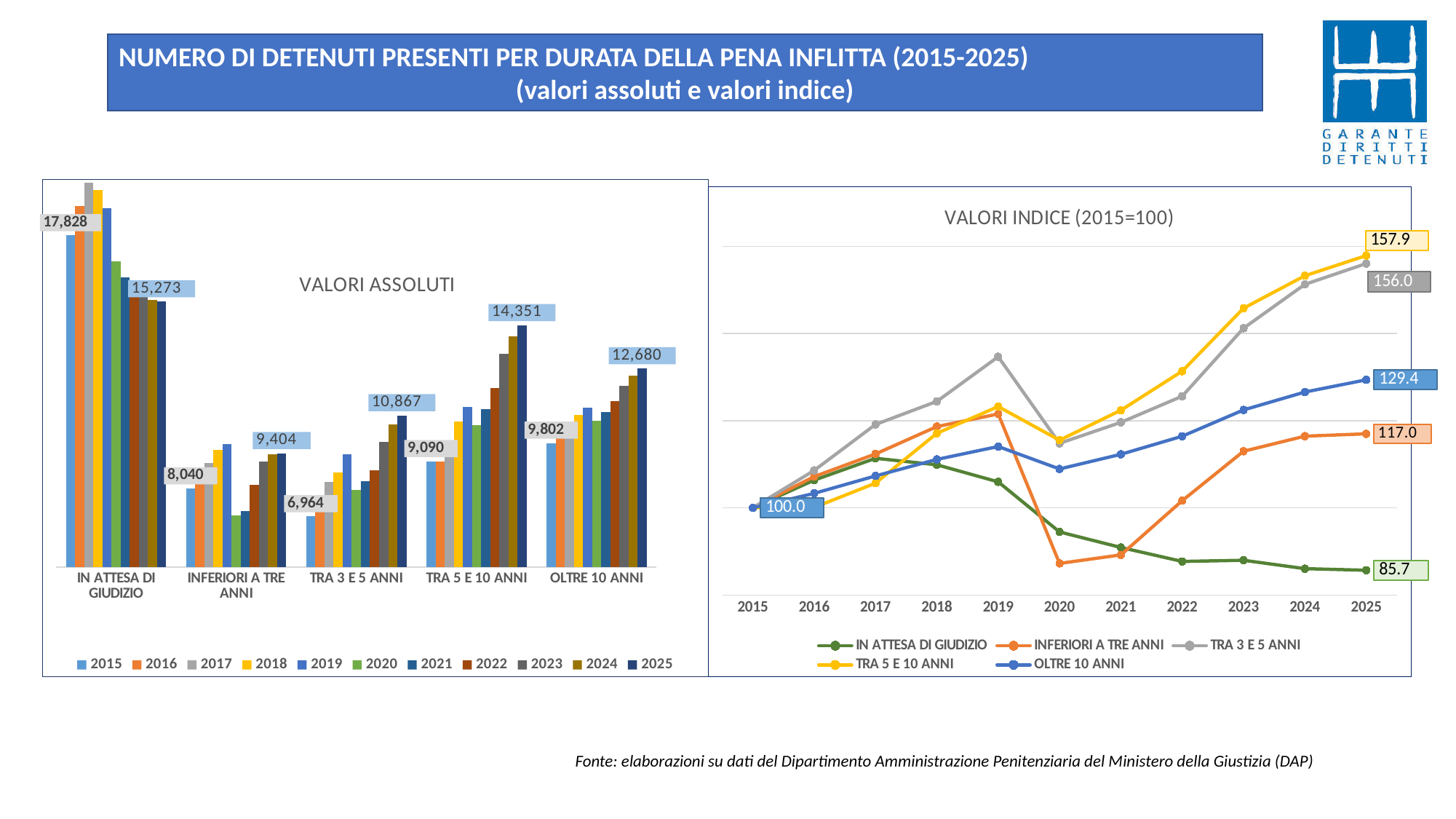
In the VALORI INDICE (2015=100) chart, which series has the highest index value in 2025? TRA 5 E 10 ANNI In the VALORI ASSOLUTI chart, which is larger in 2025: OLTRE 10 ANNI or INFERIORI A TRE ANNI? OLTRE 10 ANNI What kind of chart is the VALORI INDICE (2015=100) chart on the right? line chart In the VALORI INDICE (2015=100) chart, does the IN ATTESA DI GIUDIZIO line rise or fall from 2019 to 2025? fall In the VALORI ASSOLUTI chart, what is the 2025 value for TRA 5 E 10 ANNI? 14,351 In the VALORI ASSOLUTI chart, what is the 2015 value for IN ATTESA DI GIUDIZIO? 17,828 In the VALORI INDICE (2015=100) chart, what is the 2025 index value for IN ATTESA DI GIUDIZIO? 85.7 In the VALORI ASSOLUTI chart, how many series does the legend list? 11 In the VALORI INDICE (2015=100) chart, how many series does the legend list? 5 In the VALORI ASSOLUTI chart, what is the difference between the 2025 value (10,867) and the 2015 value (6,964) for TRA 3 E 5 ANNI? 3,903 What kind of chart is the VALORI ASSOLUTI chart on the left? bar chart In the VALORI ASSOLUTI chart, how many categories are shown on the x axis? 5